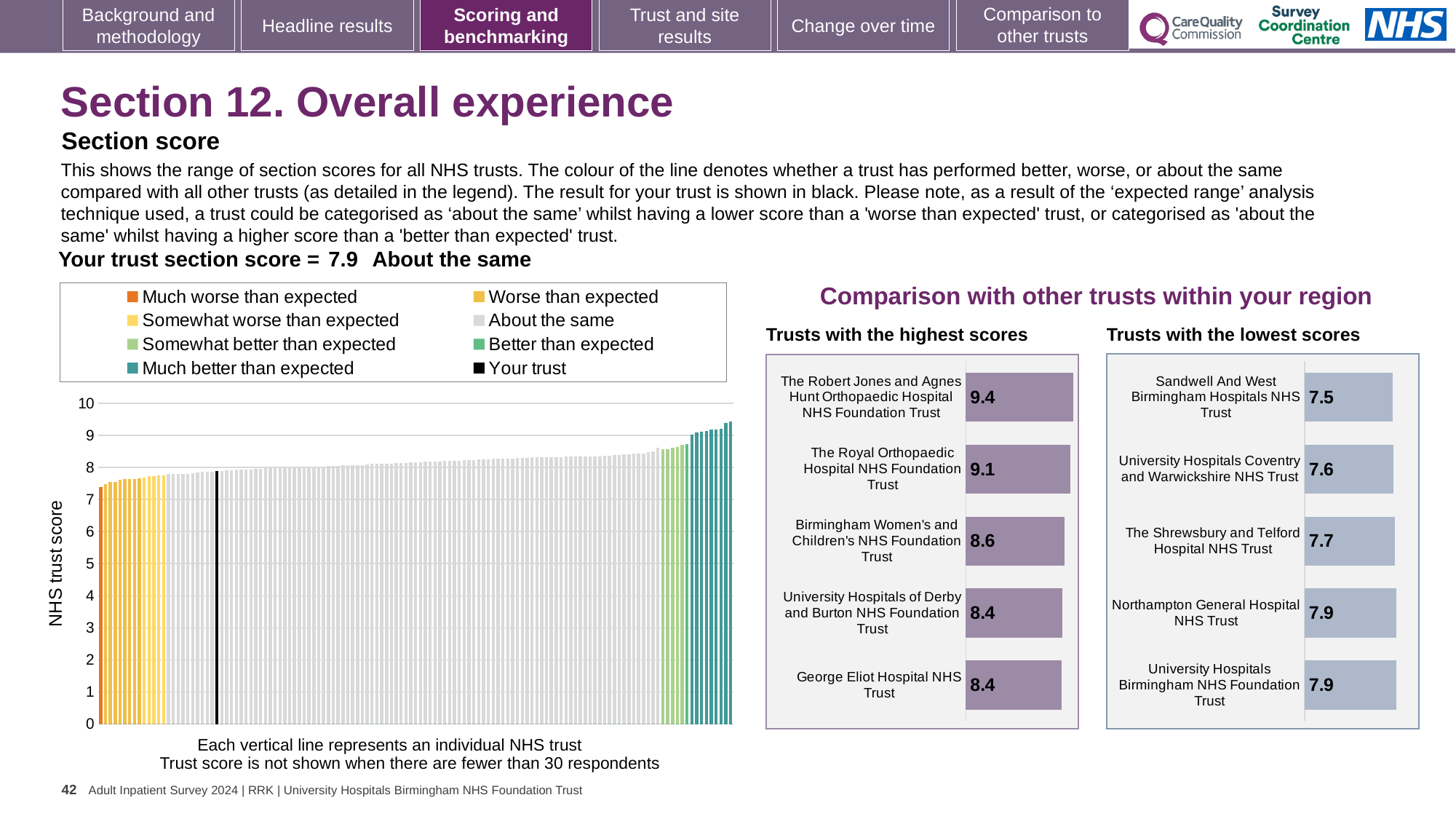
In the 'Trusts with the lowest scores' chart, which trust has the lowest score? Sandwell And West Birmingham Hospitals NHS Trust In the 'Trusts with the highest scores' chart, what is the score for Birmingham Women's and Children's NHS Foundation Trust? 8.6 In the 'Trusts with the highest scores' chart, what is the score for The Robert Jones and Agnes Hunt Orthopaedic Hospital NHS Foundation Trust? 9.4 In the 'Trusts with the lowest scores' chart, what is the difference between the scores of University Hospitals Birmingham NHS Foundation Trust and Sandwell And West Birmingham Hospitals NHS Trust? 0.4 What kind of chart is the NHS trust score chart on the left of the slide? Bar chart In the 'Trusts with the lowest scores' chart, what is the score for Sandwell And West Birmingham Hospitals NHS Trust? 7.5 How many entries does the legend of the NHS trust score chart on the left list? 8 In the 'Trusts with the highest scores' chart, which trust has the highest score? The Robert Jones and Agnes Hunt Orthopaedic Hospital NHS Foundation Trust In the 'Trusts with the lowest scores' chart, which has the higher score: University Hospitals Coventry and Warwickshire NHS Trust or The Shrewsbury and Telford Hospital NHS Trust? The Shrewsbury and Telford Hospital NHS Trust How many trusts are shown in the 'Trusts with the highest scores' chart? 5 In the NHS trust score chart on the left, do the values rise or fall from left to right along the x axis? Rise In the 'Trusts with the highest scores' chart, what is the difference between the scores of The Robert Jones and Agnes Hunt Orthopaedic Hospital NHS Foundation Trust and Birmingham Women's and Children's NHS Foundation Trust? 0.8